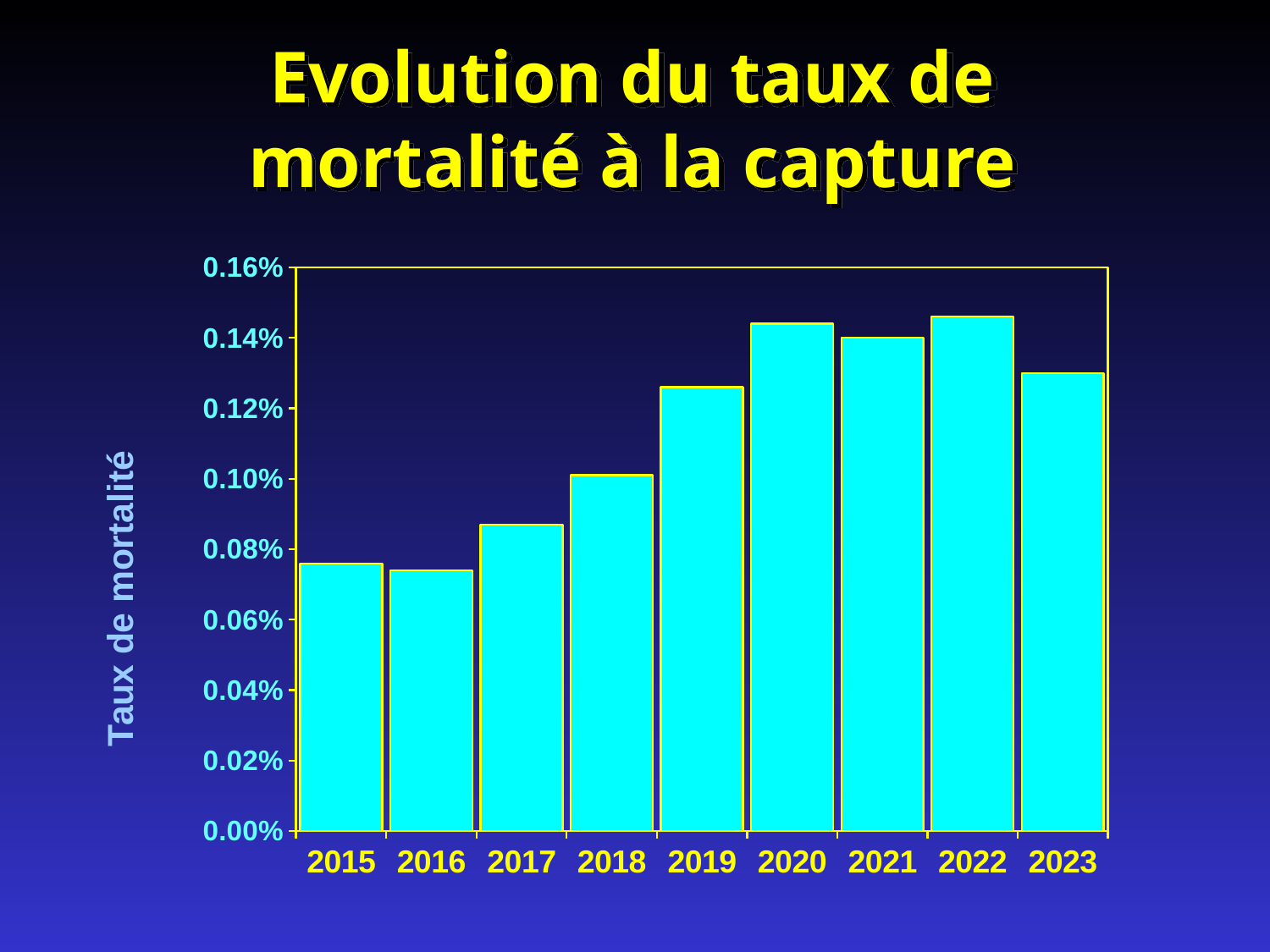
Is the value for 2020 greater or less than 0.14%? greater Which year has the larger value, 2018 or 2023? 2023 What is the title of the chart on the slide? Evolution du taux de mortalité à la capture Is the value for 2019 greater or less than 0.12%? greater Do the values generally rise or fall from 2015 to 2022? rise Is the value for 2015 greater or less than 0.08%? less How many years are shown on the x axis of the chart? 9 What is the label of the vertical axis? Taux de mortalité Which year has the larger value, 2015 or 2019? 2019 What kind of chart is shown on the slide? bar chart